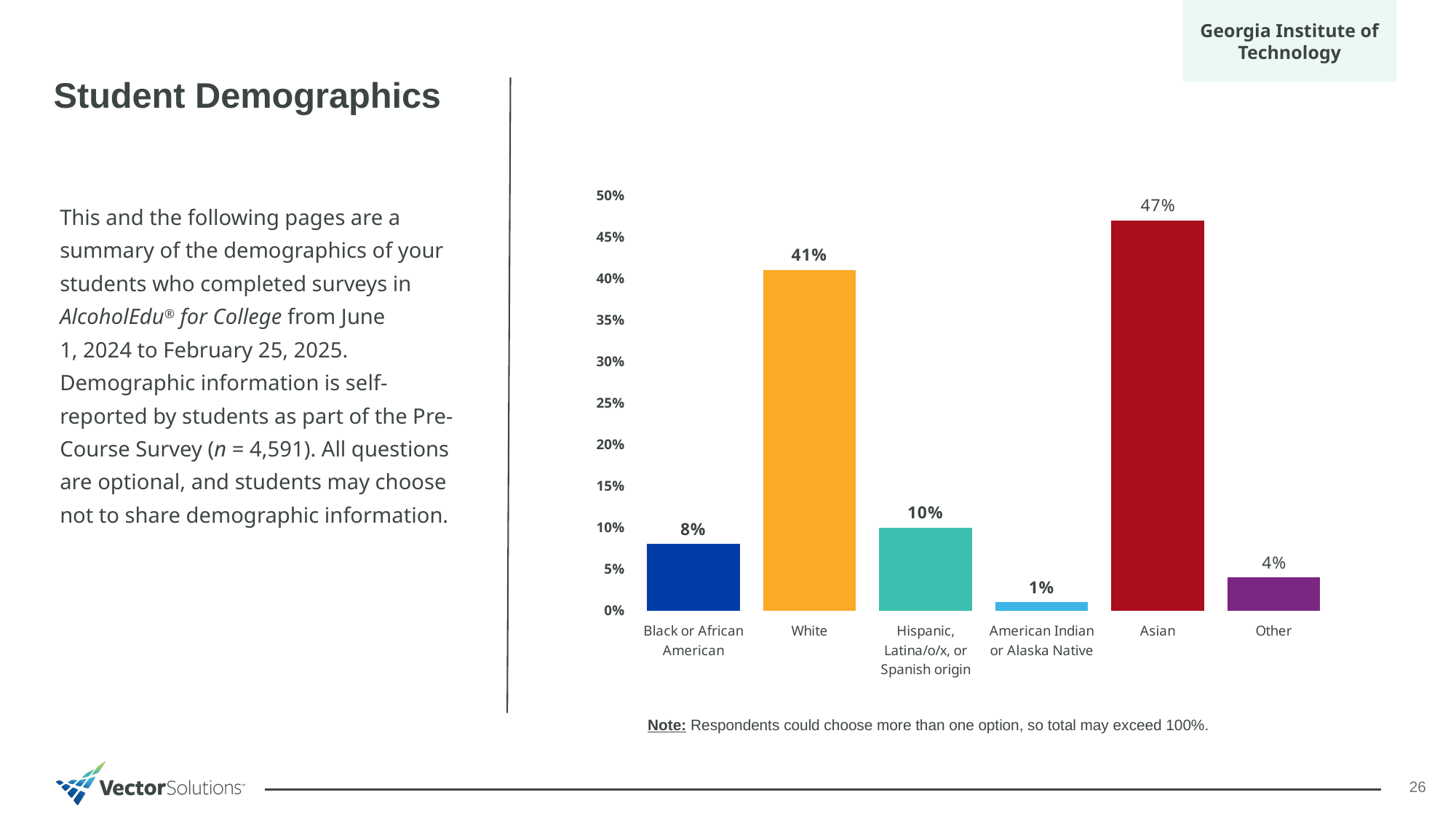
What percentage of students identified as Asian? 47% Which category has the highest value? Asian What is the value for Black or African American? 8% How many categories are shown on the x axis? 6 What kind of chart is shown on the slide? Bar chart Which is larger, the value for Hispanic, Latina/o/x, or Spanish origin or the value for Other? Hispanic, Latina/o/x, or Spanish origin What is the value for American Indian or Alaska Native? 1% Which category has the lowest value? American Indian or Alaska Native Is the value for White greater or less than 35%? greater What is the maximum value shown on the y axis? 50% What is the difference between the Asian and White percentages? 6% What percentage of students identified as White? 41%